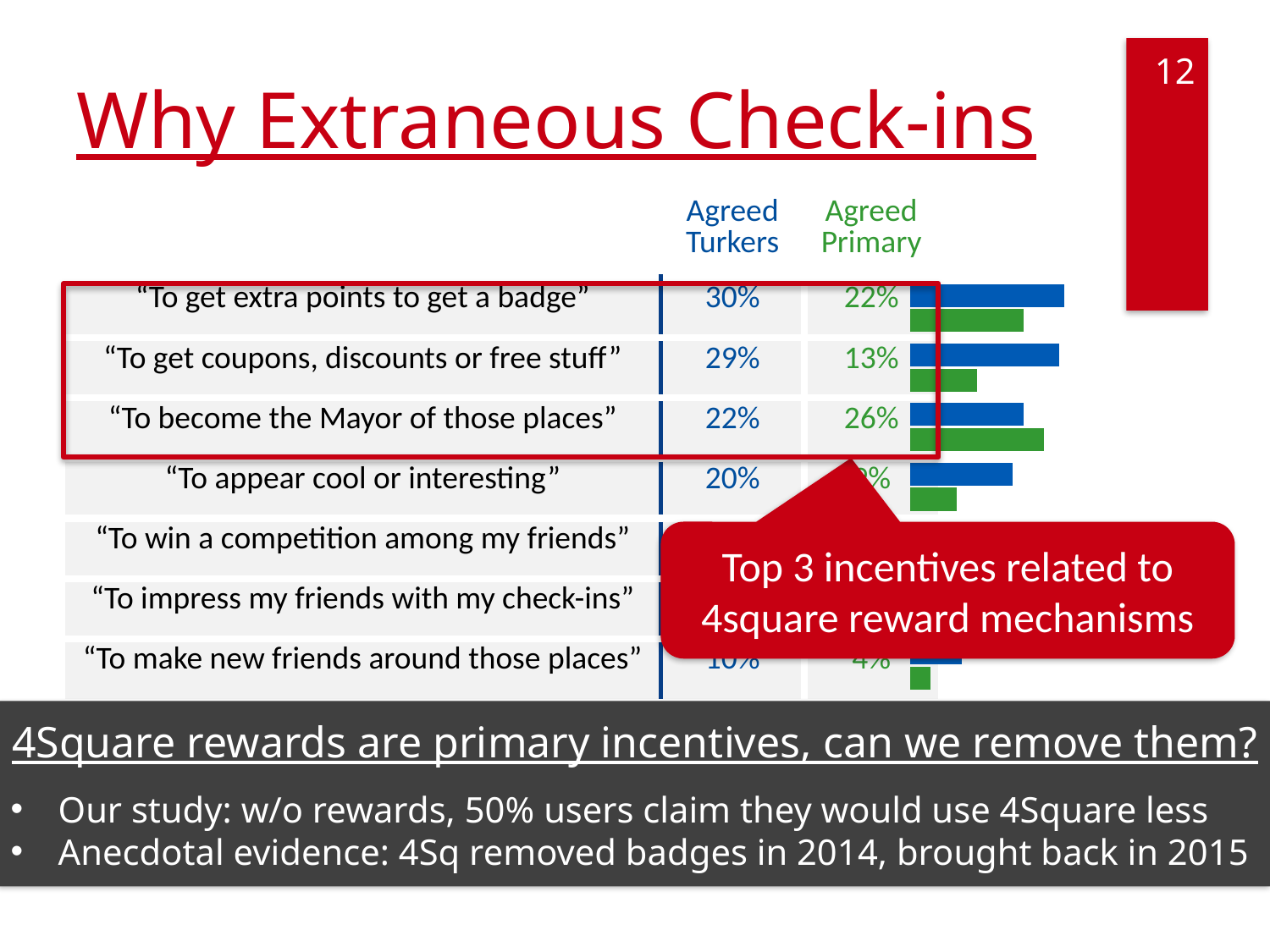
What is the Agreed Turkers value for "To appear cool or interesting"? 20% For "To become the Mayor of those places", which is larger: Agreed Turkers or Agreed Primary? Agreed Primary What is the Agreed Primary value for "To get coupons, discounts or free stuff"? 13% How many incentive statements (categories) are listed in the chart? 7 How many data series does the chart show? 2 Among the three incentives inside the red box, which has the highest Agreed Primary value? "To become the Mayor of those places" What colour are the bars for the Agreed Primary series? Green For "To get extra points to get a badge", which is larger: Agreed Turkers or Agreed Primary? Agreed Turkers What is the difference between the Agreed Turkers and Agreed Primary values for "To get coupons, discounts or free stuff"? 16 percentage points What is the Agreed Primary value for "To become the Mayor of those places"? 26% What percentage of Agreed Turkers is shown for "To get extra points to get a badge"? 30% What is the Agreed Turkers value for "To become the Mayor of those places"? 22%